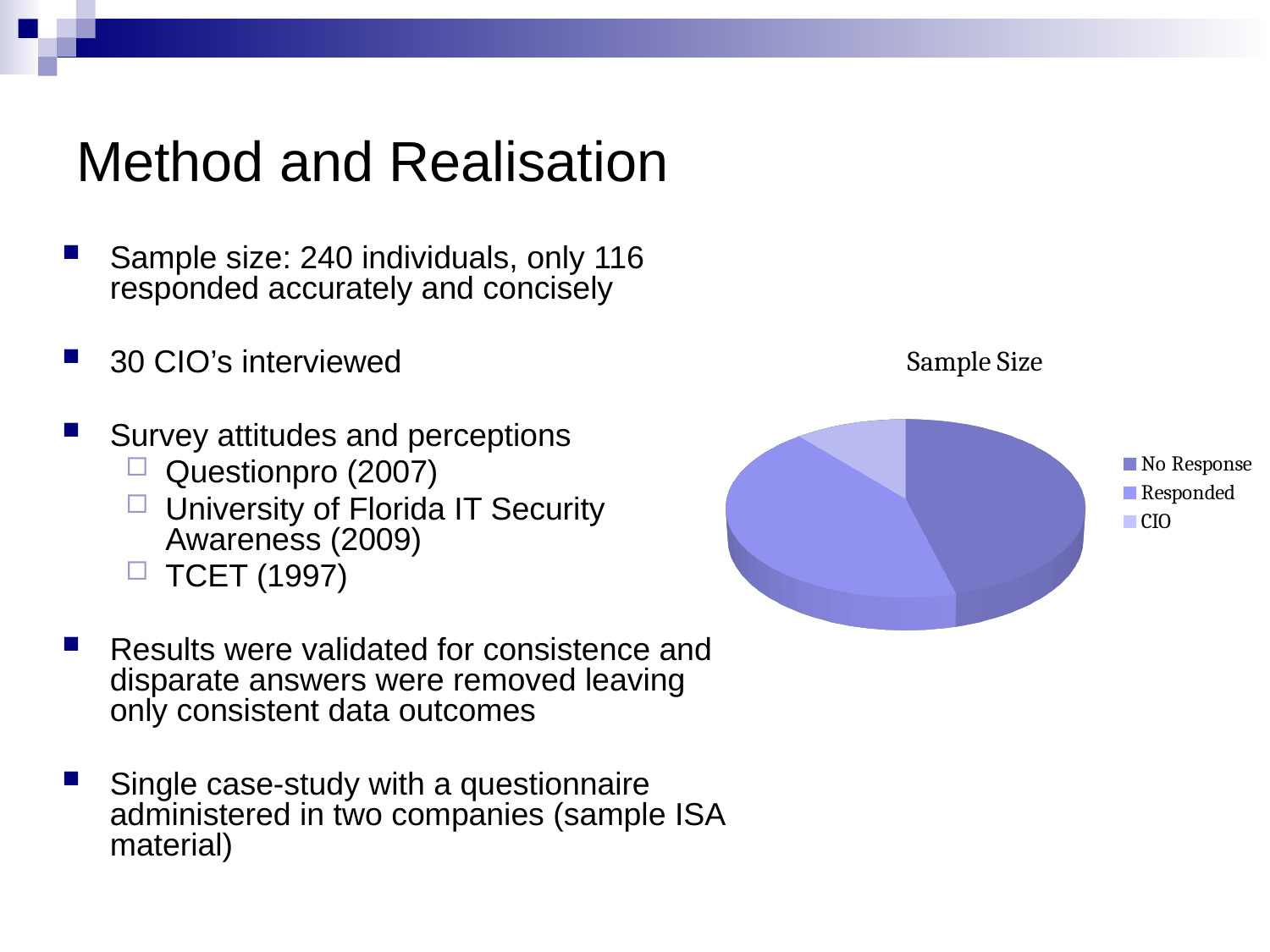
How many slices does the Sample Size pie chart have? 3 What is the title of the chart? Sample Size Which category has the smallest slice in the Sample Size pie chart? CIO In the Sample Size pie chart, which slice is larger: No Response or CIO? No Response How many entries does the legend of the Sample Size chart list? 3 In the Sample Size pie chart, which slice is larger: CIO or Responded? Responded What kind of chart is shown on the slide? pie chart What are the three categories listed in the legend of the Sample Size chart? No Response, Responded, CIO